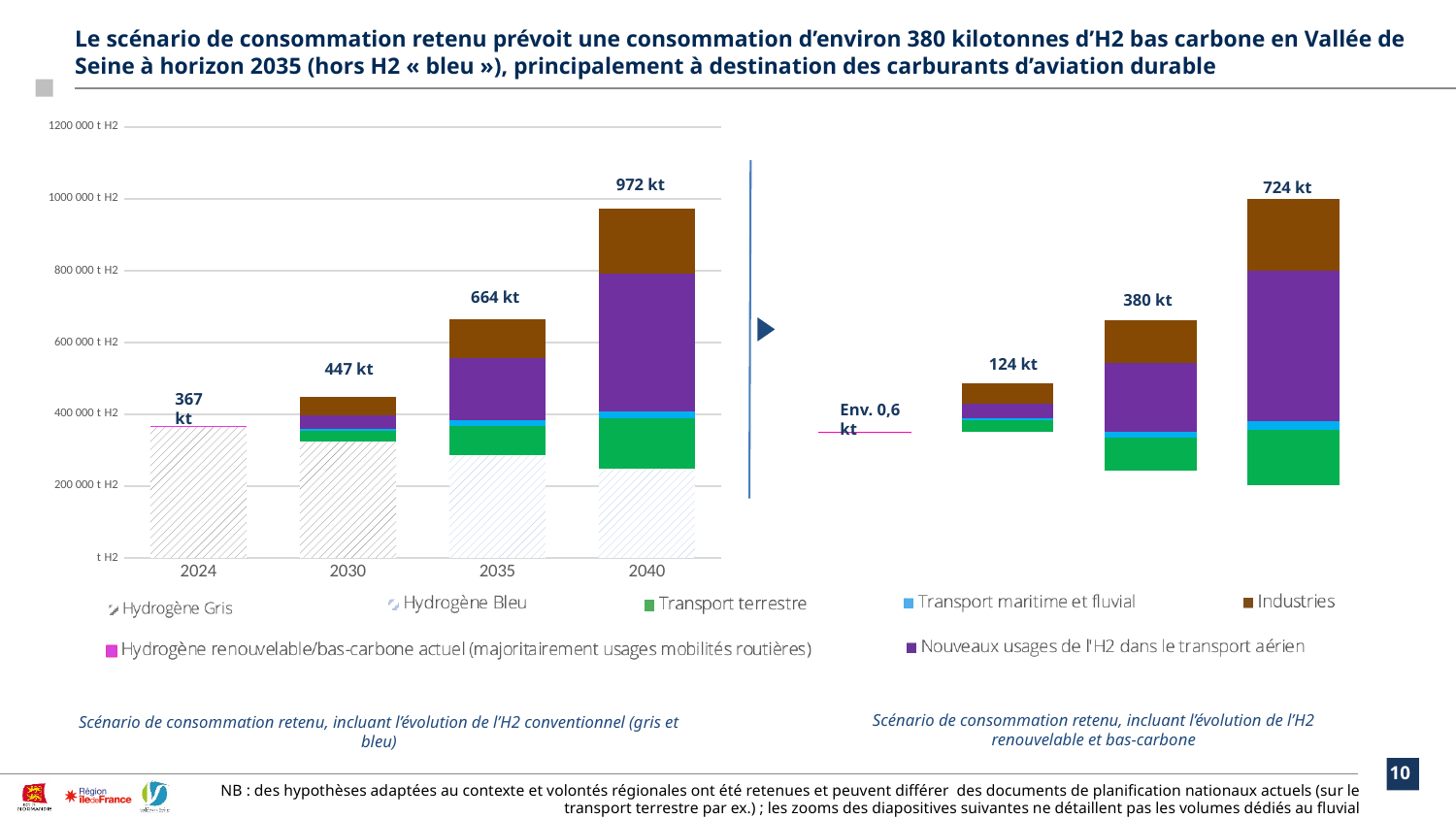
In the left chart, what is the difference between the totals for 2040 and 2035? 308 kt In the left chart, do the bar totals rise or fall from 2024 to 2040? rise In the left chart, what is the total labelled on the bar for 2035? 664 kt In the left chart, what is the difference between the totals for 2030 and 2024? 80 kt In the left chart, what is the total labelled on the bar for 2040? 972 kt In the right chart, what is the difference between the totals of the third bar (380 kt) and the second bar (124 kt)? 256 kt In the left chart, how many years are shown on the x axis? 4 In the left chart, what is the total labelled on the bar for 2024? 367 kt In the left chart, which year has the highest total? 2040 In the left chart, which year has the lowest total? 2024 In the right chart, what is the total labelled on the tallest (rightmost) bar? 724 kt In the right chart, what is the total labelled on the third bar from the left? 380 kt